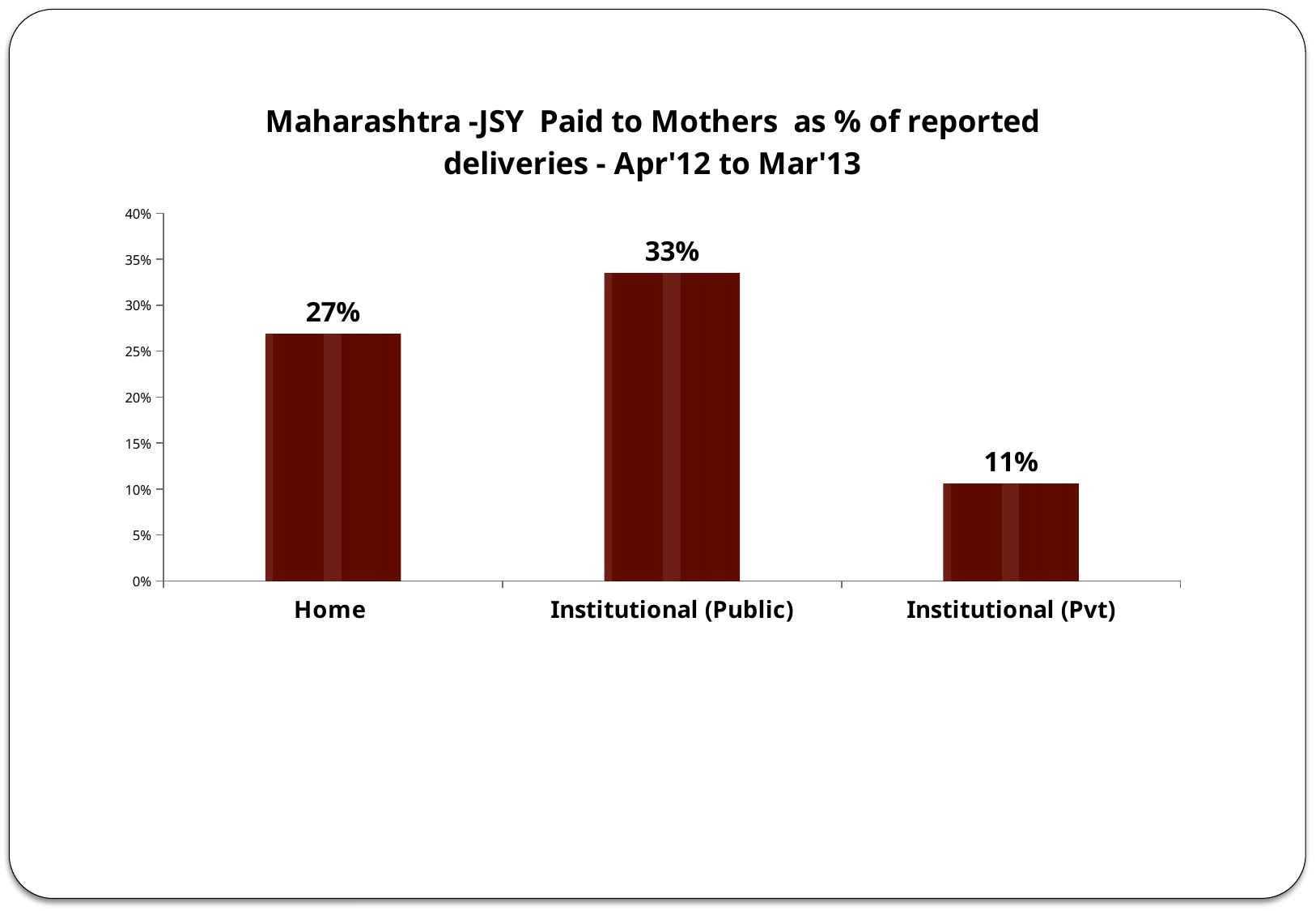
What is the value for Home? 27% Which is larger, the value for Home or the value for Institutional (Pvt)? Home What is the title of the chart? Maharashtra -JSY Paid to Mothers as % of reported deliveries - Apr'12 to Mar'13 Is the value for Institutional (Public) greater or less than 30%? greater Which category has the highest value? Institutional (Public) What kind of chart is shown on the slide? Bar chart Which category has the lowest value? Institutional (Pvt) How many categories are shown on the x axis? 3 What is the difference between the values for Home and Institutional (Pvt)? 16% What is the value for Institutional (Public)? 33% What is the difference between the values for Institutional (Public) and Home? 6% What is the value for Institutional (Pvt)? 11%